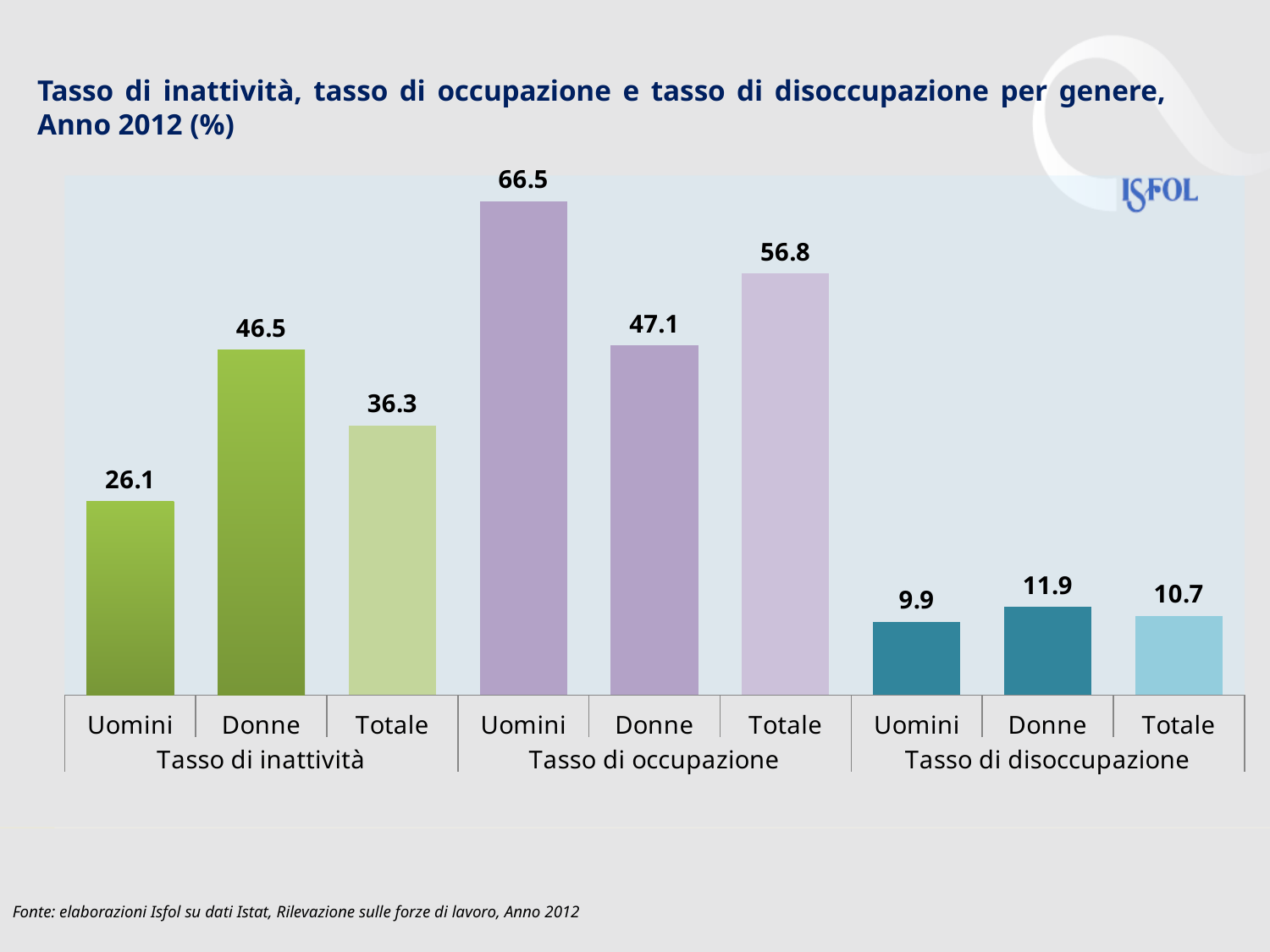
What is the title of the chart? Tasso di inattività, tasso di occupazione e tasso di disoccupazione per genere, Anno 2012 (%) What is the value for Donne under Tasso di inattività? 46.5 Which bar has the lowest value on the chart? Uomini, Tasso di disoccupazione What is the difference between the Uomini and Donne values under Tasso di occupazione? 19.4 Which bar has the highest value on the chart? Uomini, Tasso di occupazione What is the difference between the Donne and Uomini values under Tasso di inattività? 20.4 What is the value for Totale under Tasso di disoccupazione? 10.7 How many groups of categories are shown on the x axis? 3 How many bars are plotted on the chart? 9 Which is larger: Donne under Tasso di disoccupazione or Uomini under Tasso di disoccupazione? Donne under Tasso di disoccupazione What kind of chart is shown on the slide? Bar chart What is the value for Uomini under Tasso di occupazione? 66.5